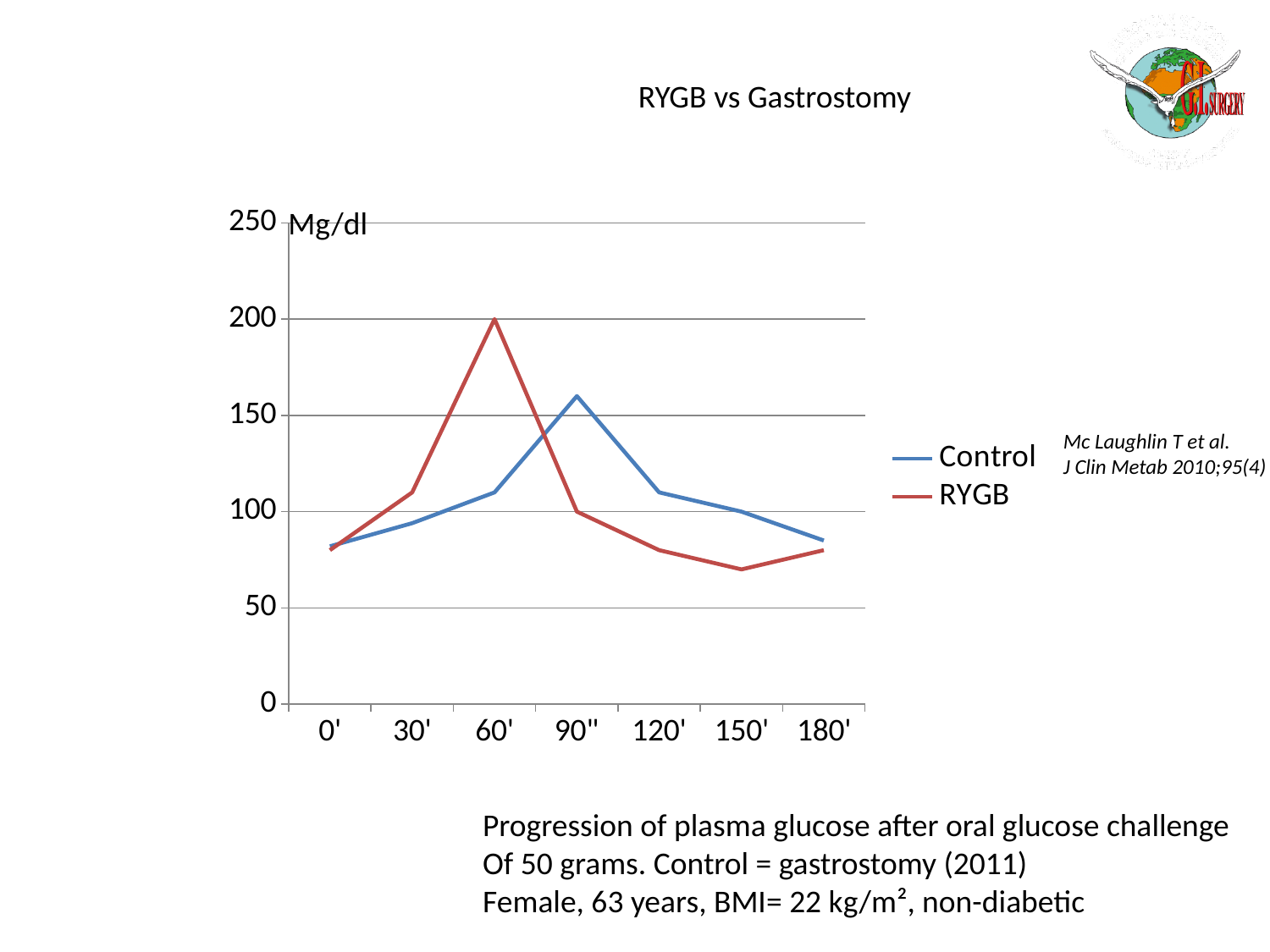
What unit is shown at the top of the y axis? Mg/dl What is the RYGB value at 60'? 200 Is the Control value at 90'' greater or less than 150? greater Does the RYGB series rise or fall between 60' and 150'? fall At which time point does the RYGB series reach its highest value? 60' At which time point does the Control series reach its highest value? 90'' What is the RYGB value at 90''? 100 Is the RYGB value at 150' greater or less than 100? less How many time points are shown along the x axis? 7 At 60', which series has the higher value, Control or RYGB? RYGB How many series does the legend list? 2 What kind of chart is shown on the slide? line chart